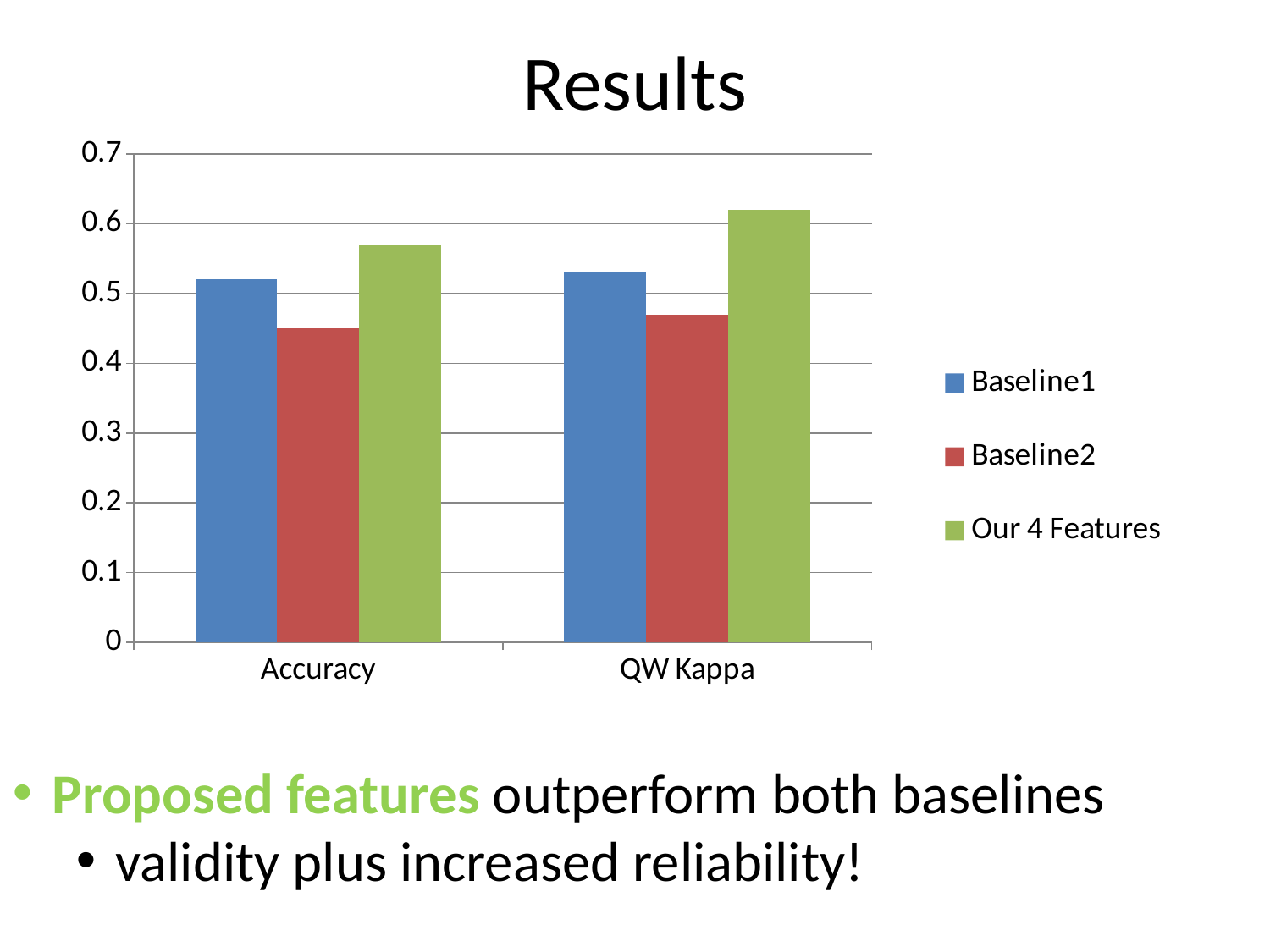
How many series does the legend list? 3 Which series is shown in green in the legend? Our 4 Features Is the value for Baseline2 on Accuracy greater or less than 0.5? less Is the value for Baseline1 on QW Kappa greater or less than 0.5? greater Which series has the lowest value for Accuracy? Baseline2 Is the value for Our 4 Features on QW Kappa greater or less than 0.6? greater Which series has the highest value for Accuracy? Our 4 Features How many categories are shown on the x axis? 2 What kind of chart is shown on the slide? bar chart For QW Kappa, which is larger: Baseline1 or Baseline2? Baseline1 Which series has the lowest value for QW Kappa? Baseline2 What is the title of the slide containing the chart? Results